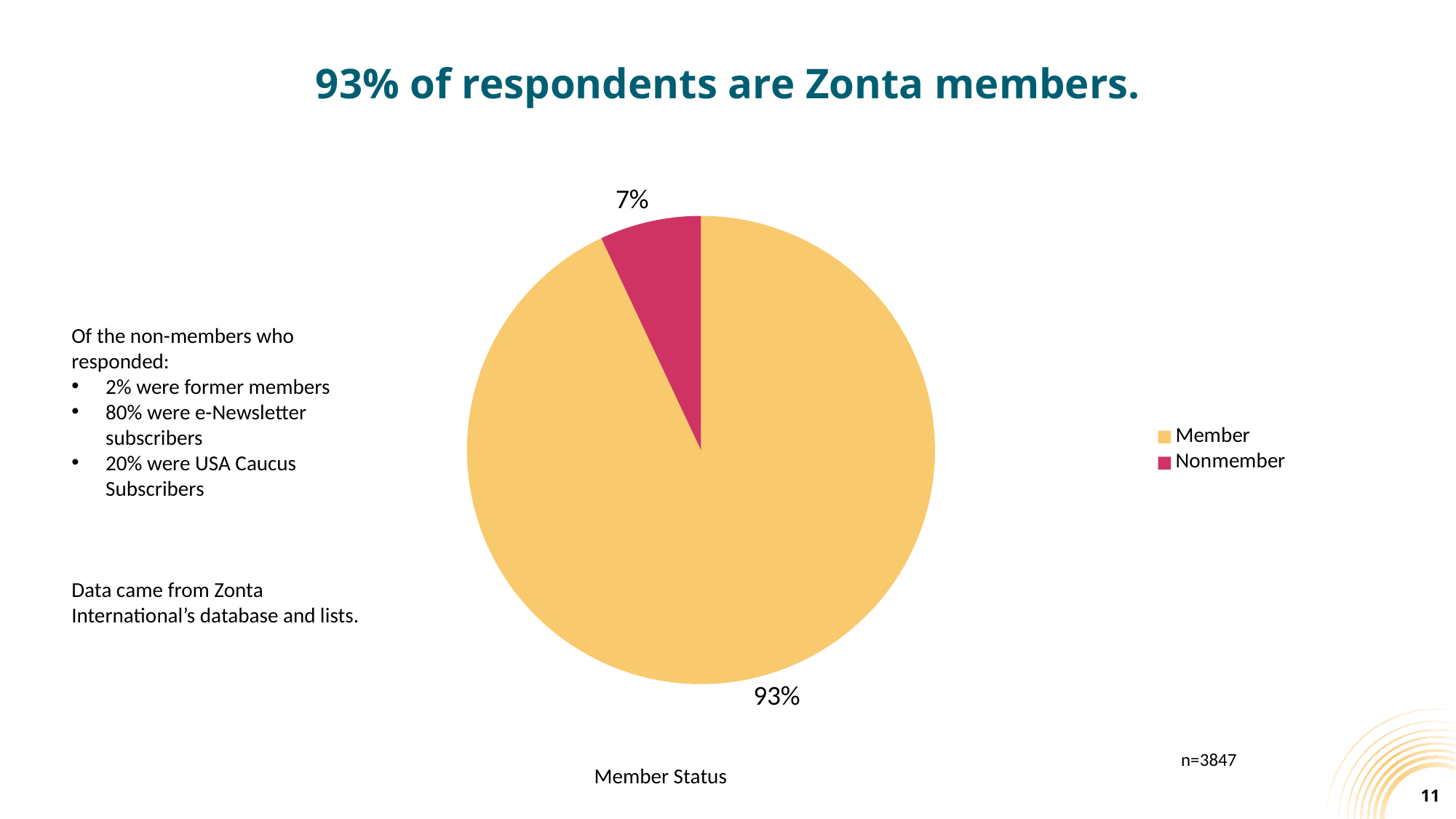
What is the title shown below the pie chart? Member Status How many slices does the pie chart have? 2 Which category has the smallest slice of the pie? Nonmember How many entries does the legend list? 2 What is the difference in percentage points between the Member and Nonmember slices? 86 What is the sample size (n) noted on the slide? n=3847 What kind of chart is shown on the slide? Pie chart What share of the pie does the Member slice represent? 93% What colour is the Nonmember slice? Magenta/pink Which category has the largest slice of the pie? Member Which slice is larger, Member or Nonmember? Member What share of the pie does the Nonmember slice represent? 7%